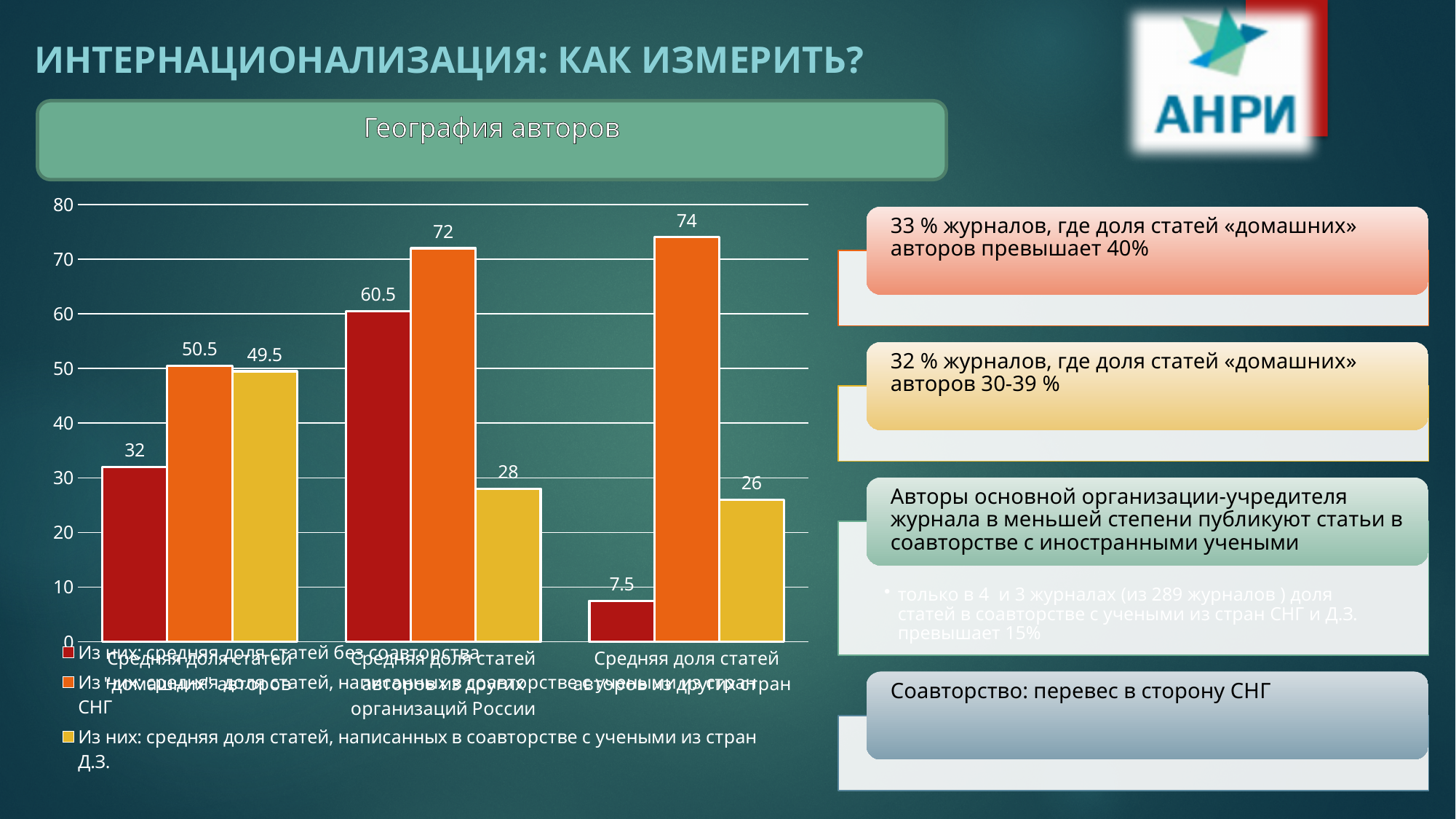
What is the value of the red bar (средняя доля статей без соавторства) for the category 'Средняя доля статей авторов из других стран'? 7.5 Which bar has the highest value in the whole chart? the orange bar for 'Средняя доля статей авторов из других стран' (74) What is the title shown above the chart? География авторов What is the value of the yellow bar (соавторство с учеными из стран Д.З.) in the first category group? 49.5 What is the value of the orange bar (соавторство с учеными из стран СНГ) for the category 'Средняя доля статей авторов из других организаций России'? 72 In the first category group, which is larger: the orange bar (50.5) or the yellow bar (49.5)? the orange bar (50.5) Is the red bar for 'Средняя доля статей авторов из других организаций России' greater or less than 60? greater How many categories are shown along the x axis of the chart? 3 What is the difference between the orange and yellow bars for the category 'Средняя доля статей авторов из других организаций России'? 44 How many series does the chart legend list? 3 What type of chart is shown on the slide? bar chart Which bar has the lowest value in the whole chart? the red bar for 'Средняя доля статей авторов из других стран' (7.5)